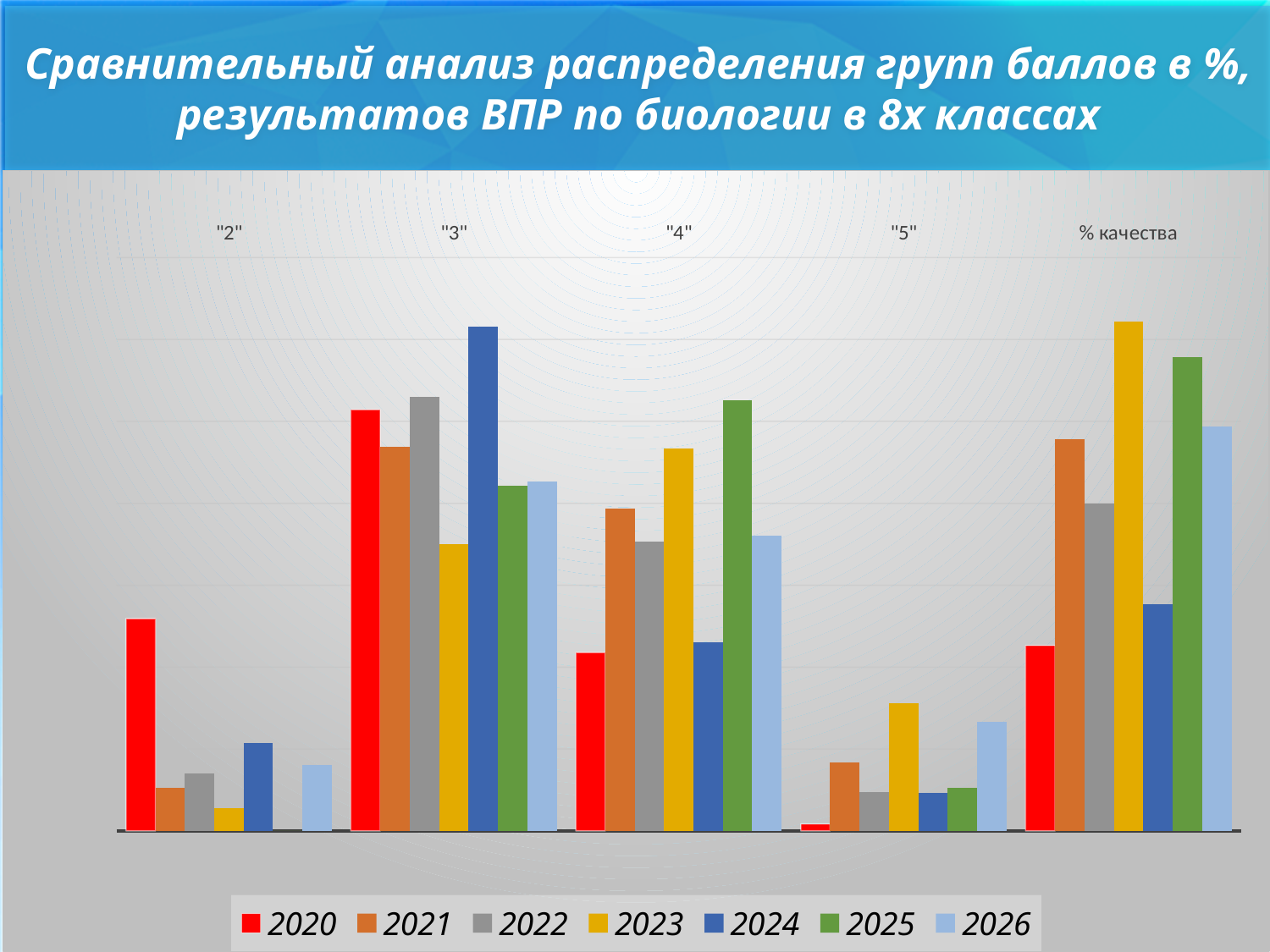
Which year is listed first in the legend? 2020 Which year has the lowest value in the "5" category? 2020 Which year has the highest value in the "3" category? 2024 Which year has the lowest value in the "3" category? 2023 In the "% качества" category, which is larger: the value for 2025 or for 2026? 2025 What kind of chart is shown on the slide? bar chart How many series does the legend list? 7 Which year has the highest value in the "4" category? 2025 How many categories are shown along the x axis? 5 Which year has the highest value in the "% качества" category? 2023